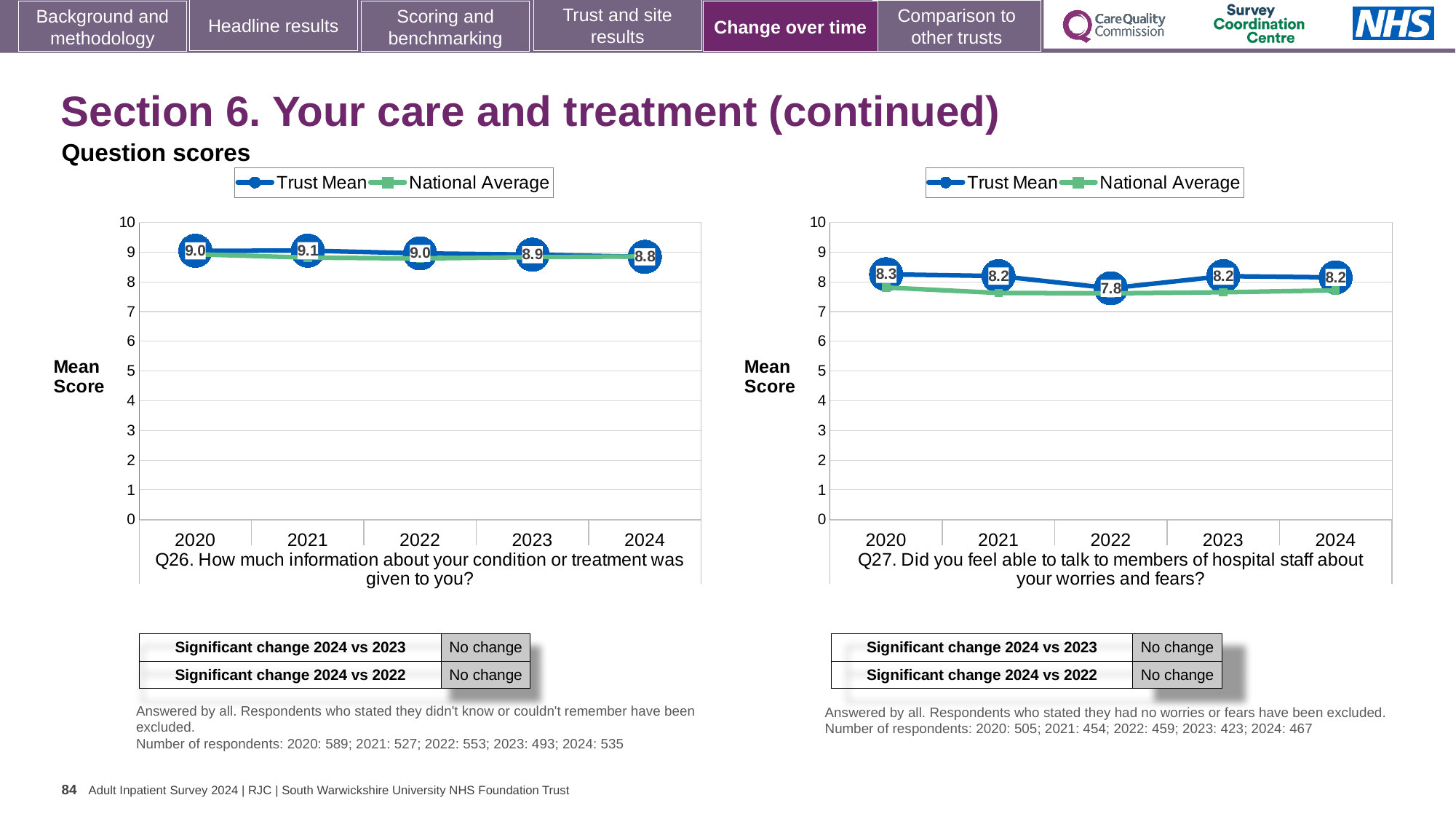
In the Q26 chart (left), does the Trust Mean score rise or fall from 2021 to 2024? Fall In the Q26 chart (left), is the Trust Mean score higher in 2020 or in 2024? 2020 How many years are plotted on the x axis of the Q26 chart (left)? 5 In the Q26 chart (left), which year has the lowest Trust Mean score? 2024 In the Q26 chart (left), which year has the highest Trust Mean score? 2021 In the Q27 chart (right), is the National Average for 2022 greater or less than 8? less In the Q27 chart (right), what is the difference between the Trust Mean scores for 2020 and 2022? 0.5 In the Q27 chart (right), what is the Trust Mean score for 2022? 7.8 How many series does the legend of the Q27 chart (right) list? 2 What type of chart is used for Q26 (left)? Line chart In the Q27 chart (right), which year has the lowest Trust Mean score? 2022 In the Q26 chart (left), what is the Trust Mean score for 2021? 9.1